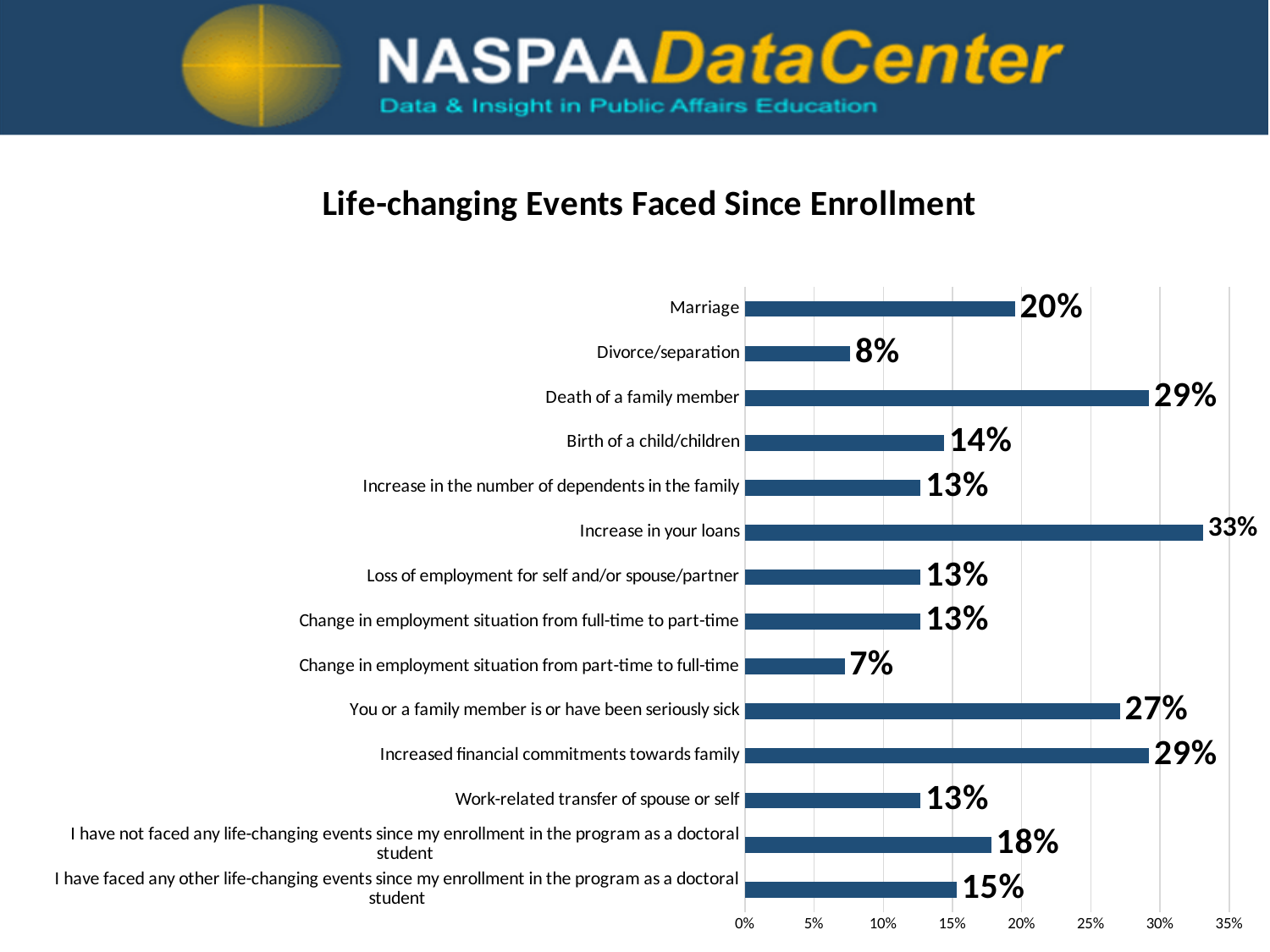
What is the difference between 'Death of a family member' and 'Divorce/separation'? 21% What percentage of respondents reported marriage as a life-changing event since enrollment? 20% How many categories are shown in the chart? 14 Which category has the lowest percentage? Change in employment situation from part-time to full-time Is the value for 'Increased financial commitments towards family' greater or less than 25%? greater What is the value for 'Increase in your loans'? 33% What percentage is shown for 'Change in employment situation from part-time to full-time'? 7% Which life-changing event has the highest percentage? Increase in your loans What is the title of the chart? Life-changing Events Faced Since Enrollment Which is larger: 'You or a family member is or have been seriously sick' or 'Birth of a child/children'? You or a family member is or have been seriously sick What is the value for 'I have not faced any life-changing events since my enrollment in the program as a doctoral student'? 18% What type of chart is shown on the slide? Bar chart